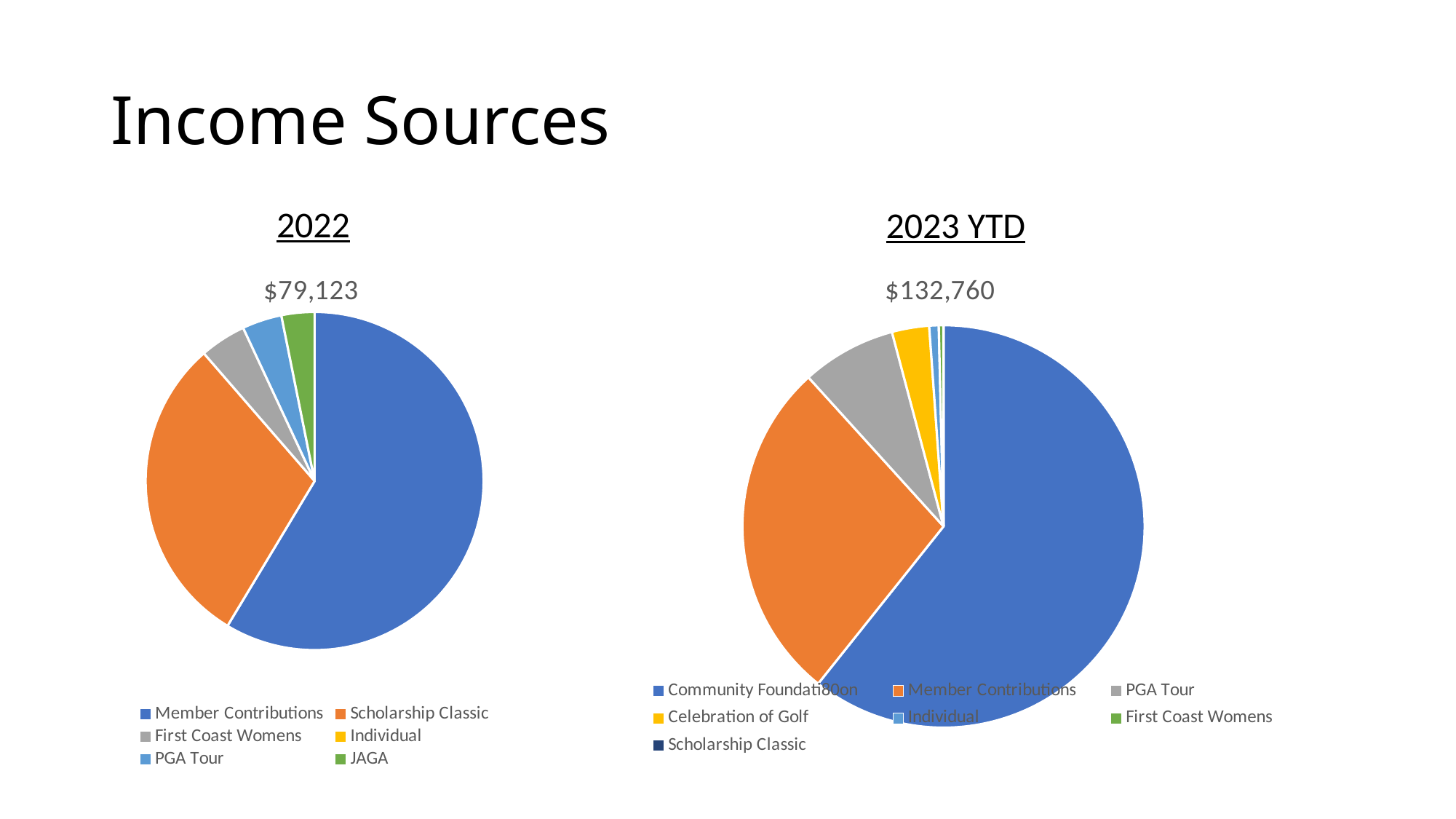
In the 2022 pie chart, which is larger: Member Contributions or Scholarship Classic? Member Contributions What total value is printed above the 2022 pie chart? $79,123 In the 2023 YTD pie chart, which category has the largest slice? Community Foundation In the 2023 YTD pie chart, which is larger: Member Contributions or PGA Tour? Member Contributions In the 2023 YTD pie chart, which is larger: PGA Tour or Celebration of Golf? PGA Tour In the 2022 pie chart, which category has the largest slice? Member Contributions What total value is printed above the 2023 YTD pie chart? $132,760 What kind of chart is the 2022 chart? pie chart What is the title of the slide containing the two pie charts? Income Sources How many categories does the legend of the 2022 pie chart list? 6 How many categories does the legend of the 2023 YTD pie chart list? 7